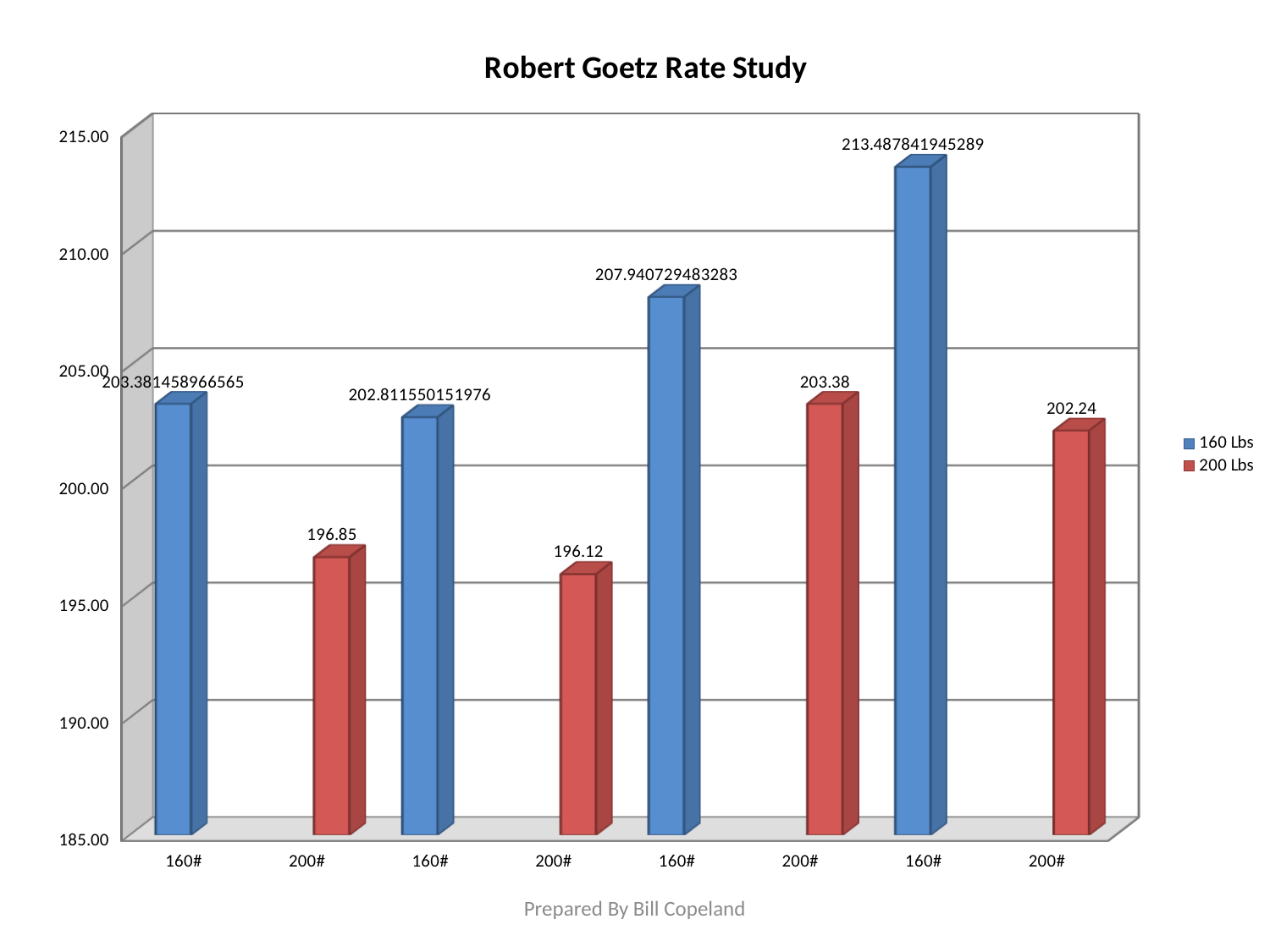
How many bars are plotted in the chart? 8 Which is larger, the first 160# bar or the first 200# bar? the first 160# bar What is the value of the rightmost bar (the last 200# bar)? 202.24 What is the difference between the third 200# bar (203.38) and the fourth 200# bar (202.24)? 1.14 How many series does the legend list? 2 What is the value of the shortest bar in the chart? 196.12 What is the difference between the first 200# bar (196.85) and the second 200# bar (196.12)? 0.73 What is the title of the chart? Robert Goetz Rate Study What is the value of the leftmost bar (the first 160# bar)? 203.381458966565 What type of chart is shown on the slide? bar chart Which series is shown in red according to the legend? 200 Lbs What is the value of the tallest bar in the chart? 213.487841945289